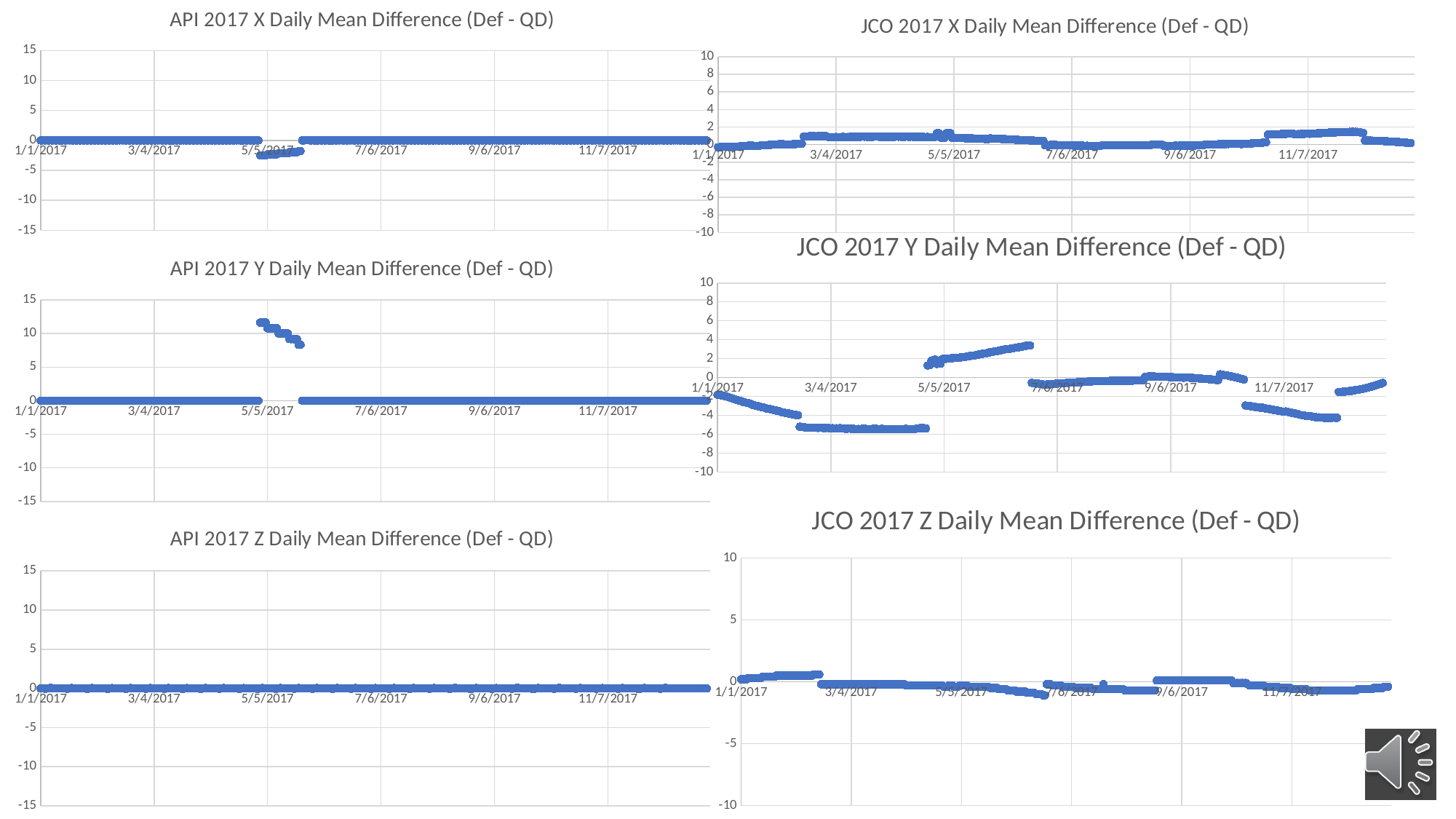
How many charts are shown on the slide? 6 What kind of chart is 'API 2017 X Daily Mean Difference (Def - QD)'? scatter chart In the 'JCO 2017 Y Daily Mean Difference (Def - QD)' chart, are the values plotted between 3/4/2017 and 5/5/2017 greater or less than -4? less In the 'API 2017 Y Daily Mean Difference (Def - QD)' chart, are the values plotted just after 5/5/2017 greater or less than 5? greater In the 'API 2017 X Daily Mean Difference (Def - QD)' chart, are the values plotted just after 5/5/2017 greater or less than 0? less In the 'JCO 2017 Y Daily Mean Difference (Def - QD)' chart, do the values rise or fall from 1/1/2017 to 3/4/2017? fall What is the highest value shown on the vertical axis of the 'API 2017 Z Daily Mean Difference (Def - QD)' chart? 15 In the 'JCO 2017 Y Daily Mean Difference (Def - QD)' chart, do the values rise or fall between 5/5/2017 and 7/6/2017? rise Which of the six charts has points plotted above 10? API 2017 Y Daily Mean Difference (Def - QD) In the 'API 2017 Y Daily Mean Difference (Def - QD)' chart, are the values just after 5/5/2017 higher or lower than the values around 9/6/2017? higher